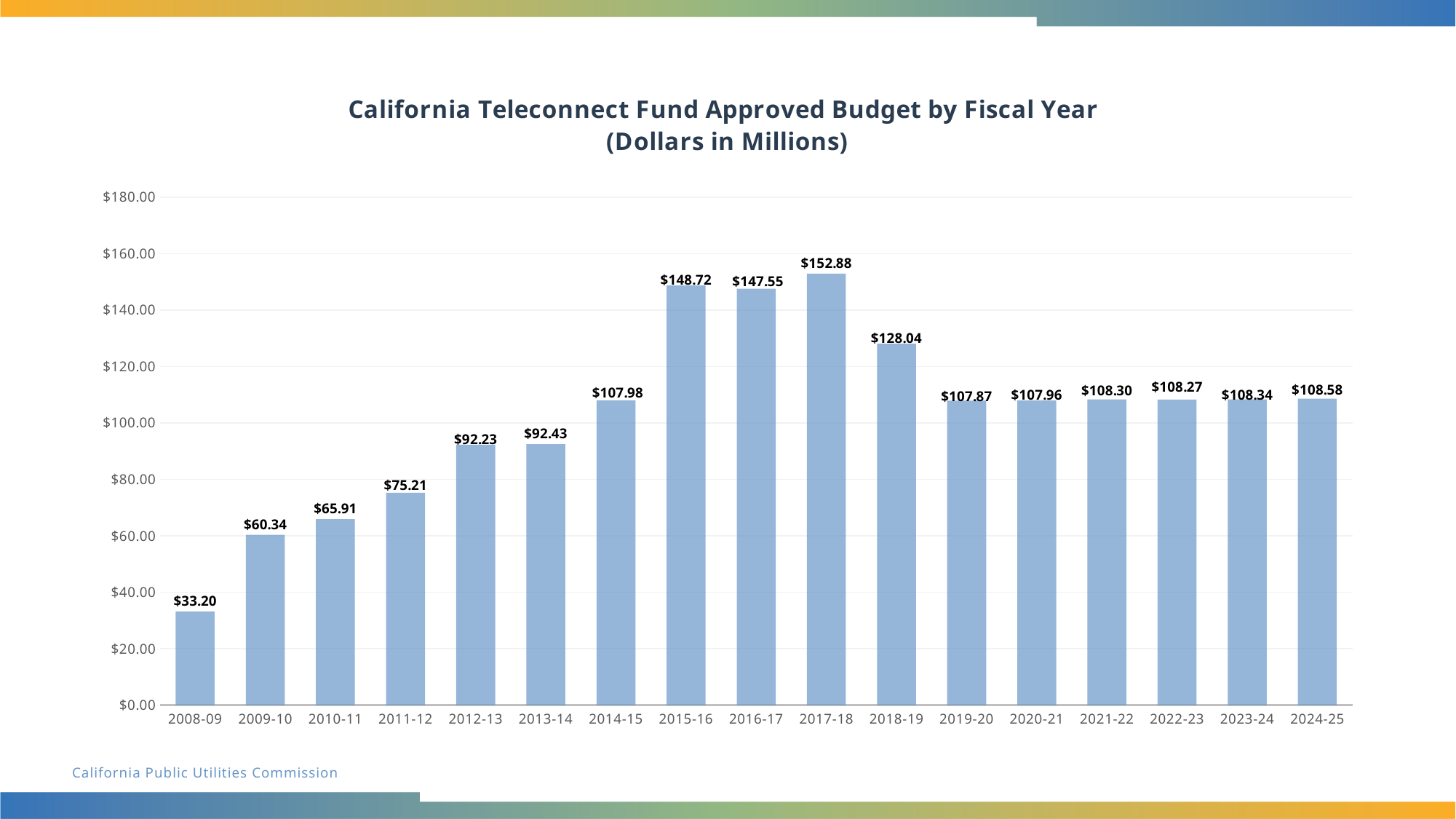
Which fiscal year has the lowest approved budget? 2008-09 Which fiscal year has a larger approved budget, 2014-15 or 2018-19? 2018-19 Do the approved budgets rise or fall from 2008-09 to 2014-15? Rise What is the approved budget for fiscal year 2017-18? $152.88 Which fiscal year has the highest approved budget? 2017-18 How many fiscal years are shown on the chart? 17 What is the approved budget for fiscal year 2008-09? $33.20 What kind of chart is shown on the slide? Bar chart What is the approved budget for fiscal year 2024-25? $108.58 What is the difference between the approved budgets for 2017-18 and 2008-09? $119.68 Which fiscal year has a larger approved budget, 2015-16 or 2016-17? 2015-16 What is the difference between the approved budgets for 2018-19 and 2019-20? $20.17